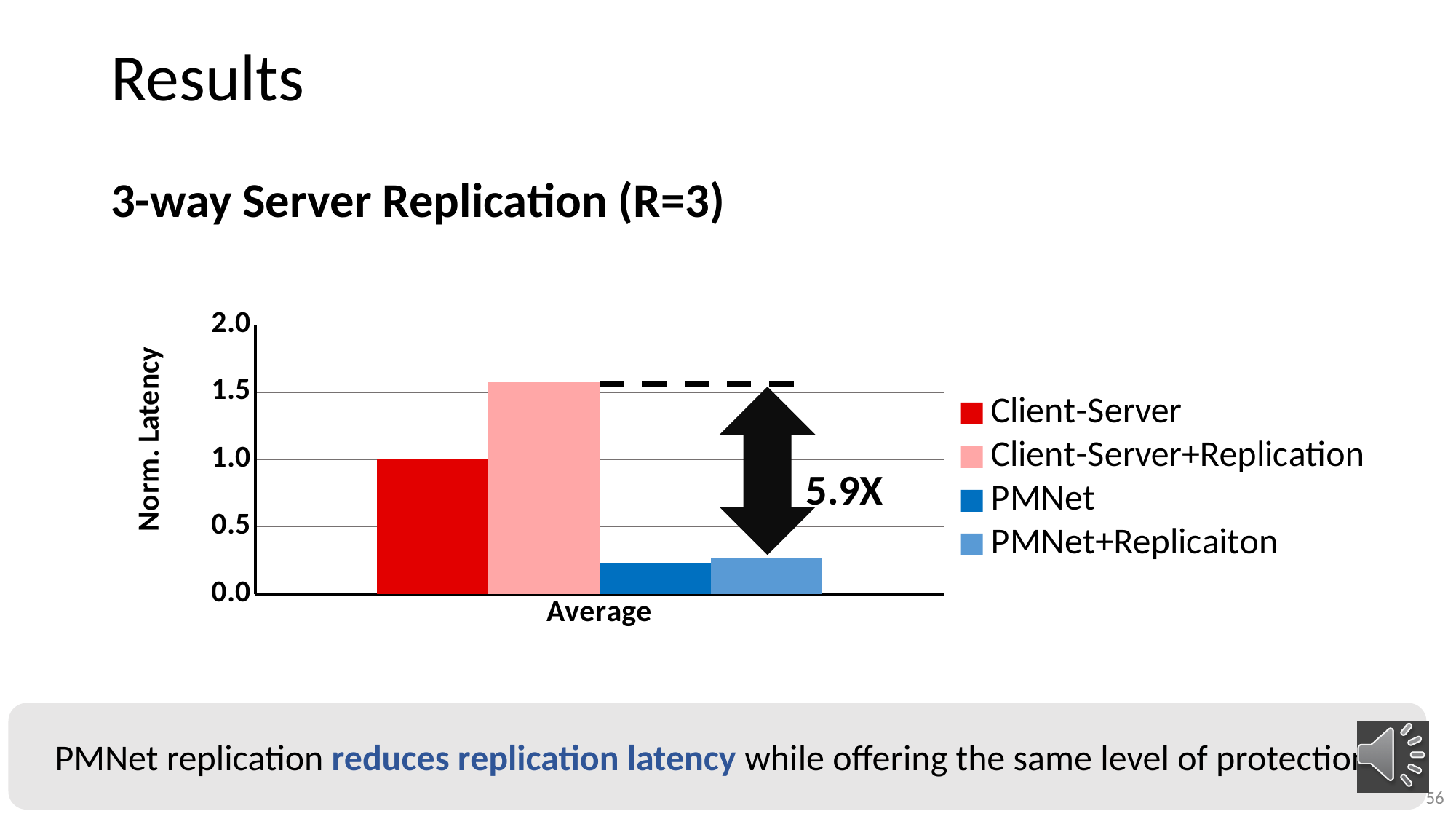
Which series has the highest normalized latency in the chart? Client-Server+Replication What kind of chart is shown on the slide? bar chart What factor is printed next to the arrow between the Client-Server+Replication bar and the PMNet+Replicaiton bar? 5.9X What is the label of the y axis of the chart? Norm. Latency What is the normalized latency value for Client-Server in the Average category? 1.0 Which is larger, the value for Client-Server or the value for PMNet? Client-Server Is the value for PMNet greater or less than 0.5? less Is the value for Client-Server+Replication greater or less than 1.5? greater Is the value for PMNet+Replicaiton greater or less than 0.5? less Which is larger, the value for Client-Server+Replication or the value for Client-Server? Client-Server+Replication How many series does the chart's legend list? 4 How many categories are shown on the x axis of the chart? 1